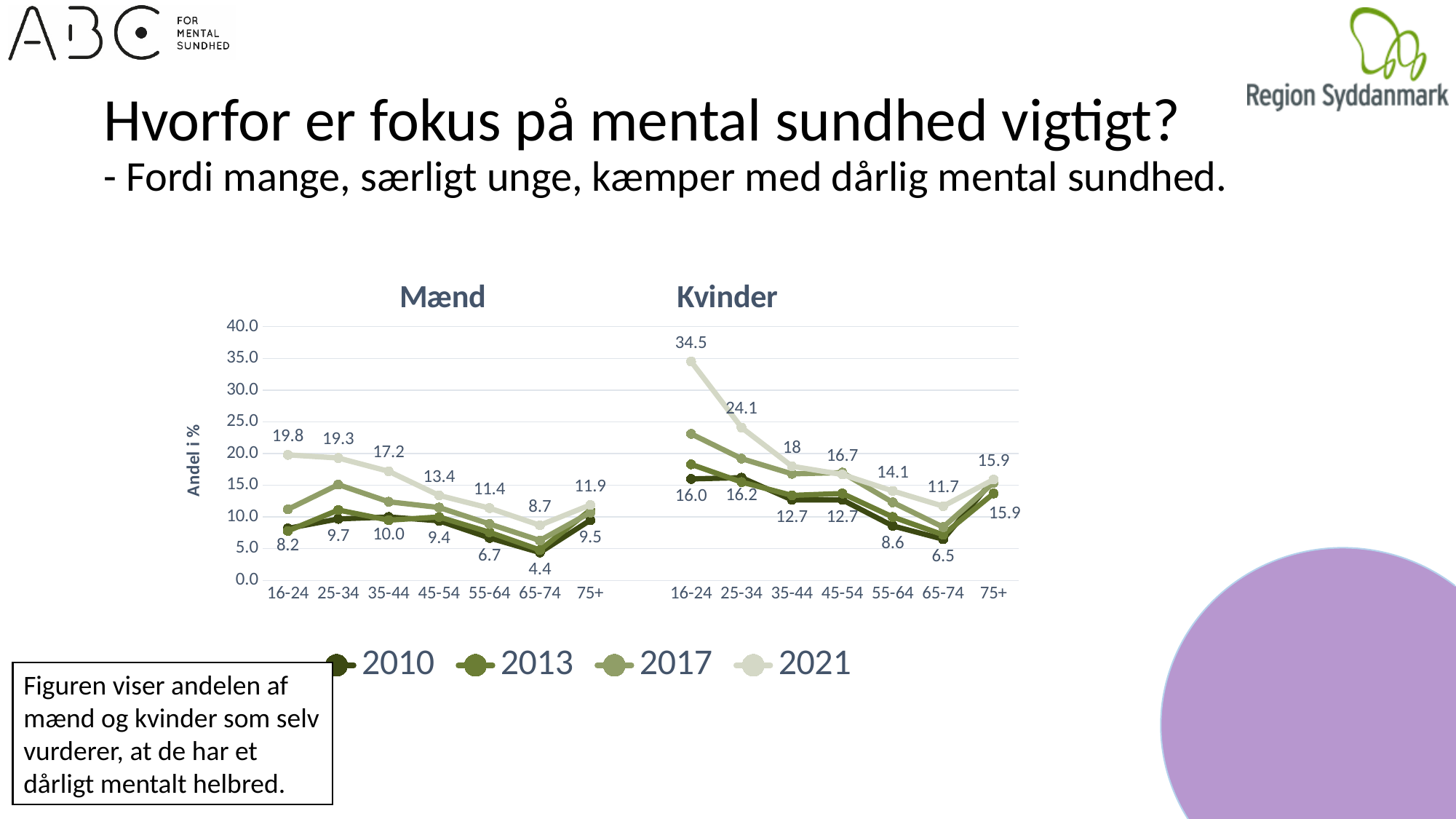
In the Mænd chart, which age group has the lowest 2010 value? 65-74 In the Mænd chart, does the 2021 line rise or fall from 16-24 to 65-74? Fall How many series does the legend list? 4 In the Kvinder chart, what is the difference between the 2021 values for 16-24 and 25-34? 10.4 For the 16-24 age group in 2021, which chart shows the larger value, Mænd or Kvinder? Kvinder In the Mænd chart, what is the 2021 value for the 16-24 age group? 19.8 What kind of chart is the Mænd chart? Line chart How many age groups are shown on the x axis of the Kvinder chart? 7 In the Mænd chart, what is the 2010 value for the 65-74 age group? 4.4 What is the label on the y axis of the charts? Andel i % In the Kvinder chart, which age group has the highest 2021 value? 16-24 In the Kvinder chart, what is the 2021 value for the 16-24 age group? 34.5